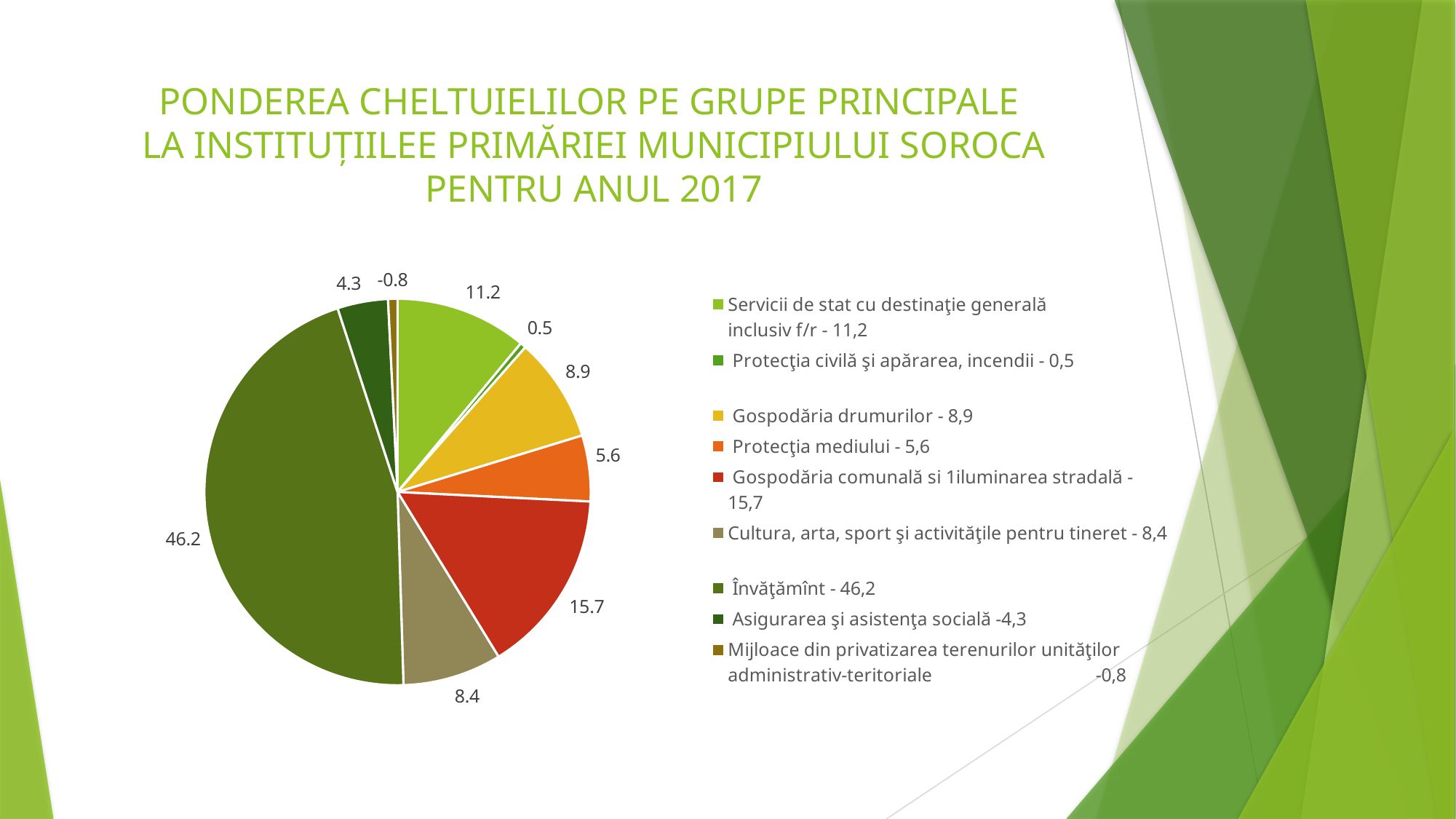
Which is larger, the value for Gospodăria drumurilor or the value for Cultura, arta, sport şi activităţile pentru tineret? Gospodăria drumurilor How many slices does the pie chart have? 9 What is the difference between the values for Învăţămînt and Gospodăria comunală si iluminarea stradală? 30.5 Which category has the largest slice of the pie? Învăţămînt What is the value shown for Asigurarea şi asistenţa socială? 4.3 What is the value shown for Gospodăria comunală si iluminarea stradală? 15.7 What type of chart is shown on the slide? pie chart What is the difference between the values for Servicii de stat cu destinaţie generală inclusiv f/r and Gospodăria drumurilor? 2.3 How many entries does the legend list? 9 What is the value shown for Protecţia mediului? 5.6 Which category has the lowest value shown on the chart? Mijloace din privatizarea terenurilor unităţilor administrativ-teritoriale What is the value shown for Învăţămînt? 46.2